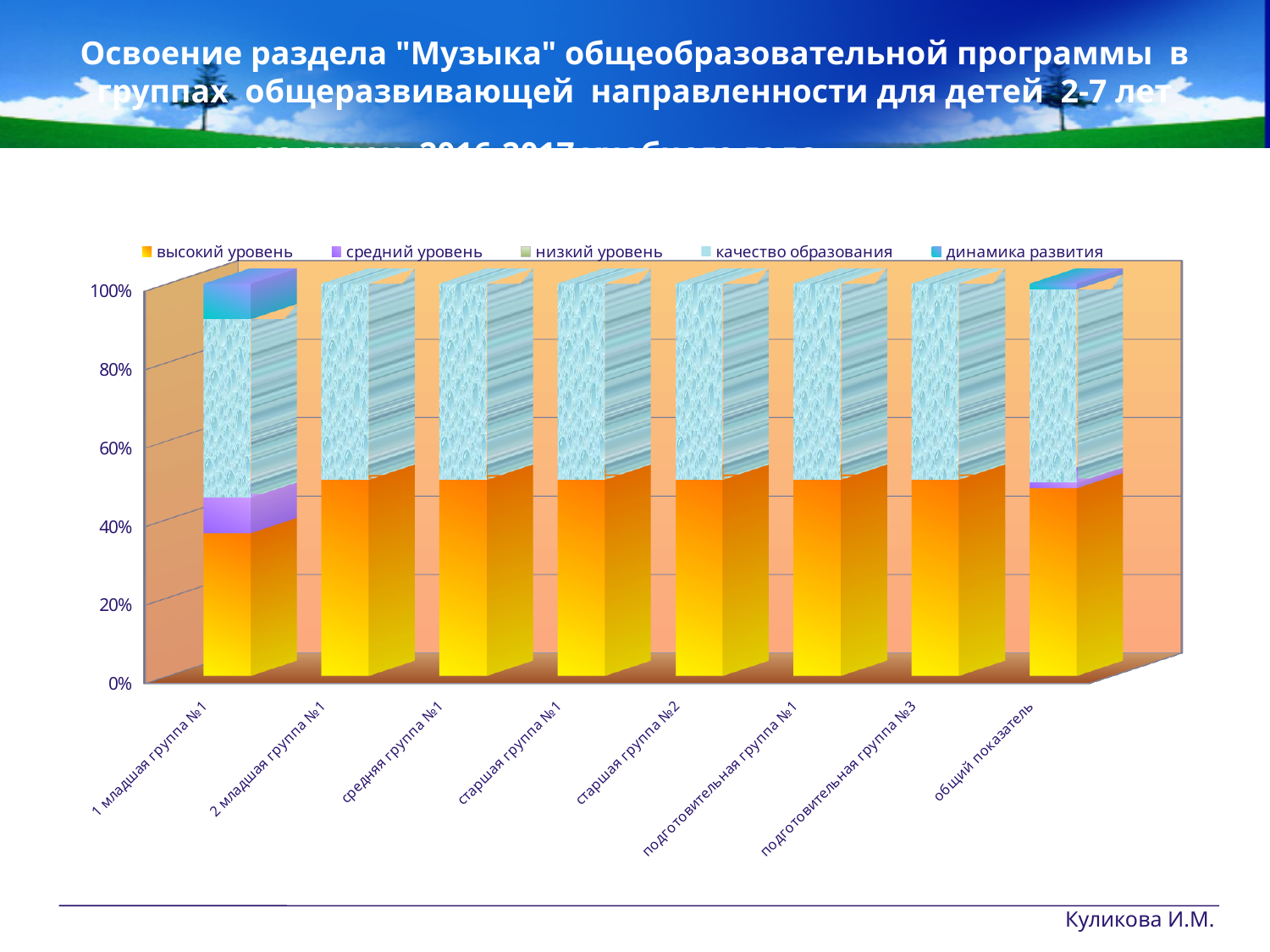
Which series is listed last in the chart legend? динамика развития Is the value for 'высокий уровень' in '1 младшая группа №1' greater or less than 20%? greater Which series is listed first in the chart legend? высокий уровень Which category has the lowest value for 'высокий уровень'? 1 младшая группа №1 What is the highest tick value shown on the y axis? 100% Which is larger: the 'высокий уровень' value for '1 младшая группа №1' or for 'средняя группа №1'? средняя группа №1 What kind of chart is shown on the slide? stacked bar chart How many series does the chart legend list? 5 How many categories (groups) are shown along the x axis of the chart? 8